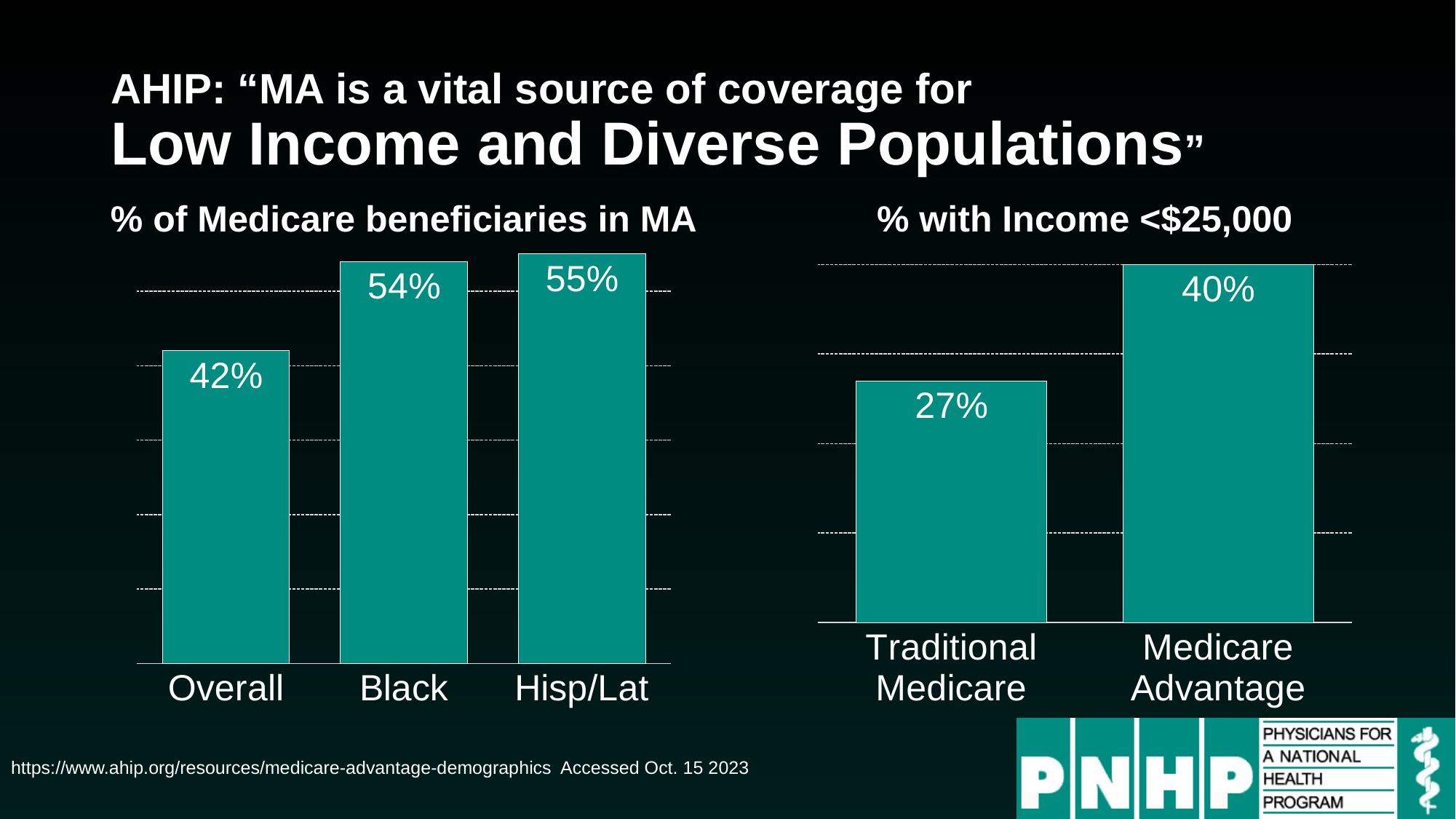
In the '% of Medicare beneficiaries in MA' chart, which category has the highest value? Hisp/Lat In the '% of Medicare beneficiaries in MA' chart, what is the difference between Black and Overall? 12% How many categories are shown in the '% of Medicare beneficiaries in MA' chart? 3 What type of chart is the '% with Income <$25,000' chart? Bar chart In the '% with Income <$25,000' chart, what is the difference between Medicare Advantage and Traditional Medicare? 13% In the '% with Income <$25,000' chart, what is the value for Medicare Advantage? 40% How many categories are shown in the '% with Income <$25,000' chart? 2 In the '% with Income <$25,000' chart, which is larger, Traditional Medicare or Medicare Advantage? Medicare Advantage In the '% of Medicare beneficiaries in MA' chart, what is the value for Overall? 42% In the '% with Income <$25,000' chart, what is the value for Traditional Medicare? 27% In the '% of Medicare beneficiaries in MA' chart, what is the value for Black? 54% In the '% of Medicare beneficiaries in MA' chart, which category has the lowest value? Overall